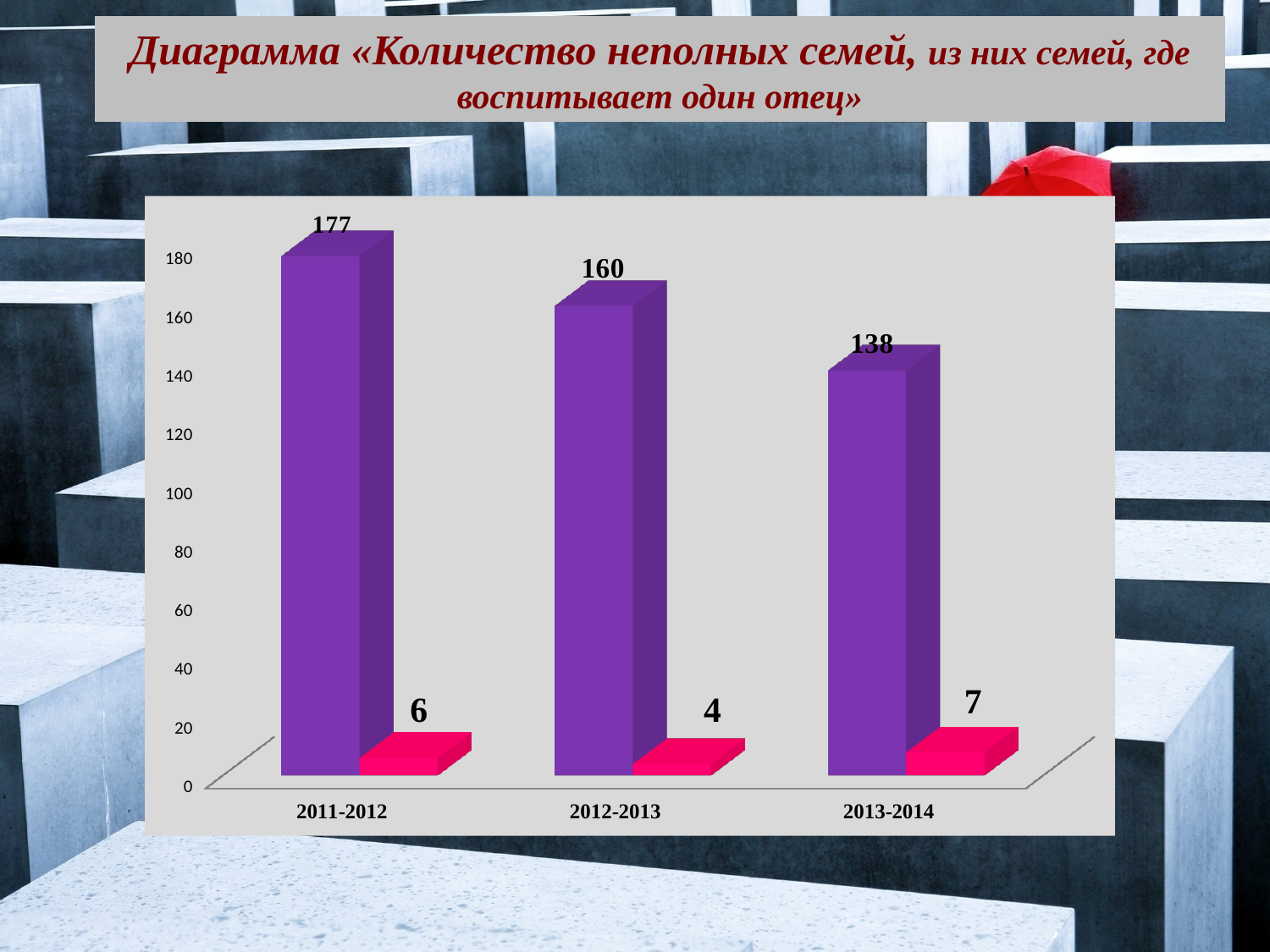
What is the value of the purple bar for 2011-2012? 177 What kind of chart is shown on the slide? bar chart What is the difference between the purple bars for 2011-2012 and 2013-2014? 39 Do the purple bars rise or fall from 2011-2012 to 2013-2014? fall What is the highest value shown on the vertical axis? 180 Which period has the highest purple bar? 2011-2012 Which period has the lowest pink bar? 2012-2013 What is the value of the pink bar for 2013-2014? 7 How many periods are shown on the x axis? 3 What is the value of the pink bar for 2012-2013? 4 Which is larger: the purple bar for 2012-2013 or the purple bar for 2013-2014? 2012-2013 What is the value of the purple bar for 2013-2014? 138